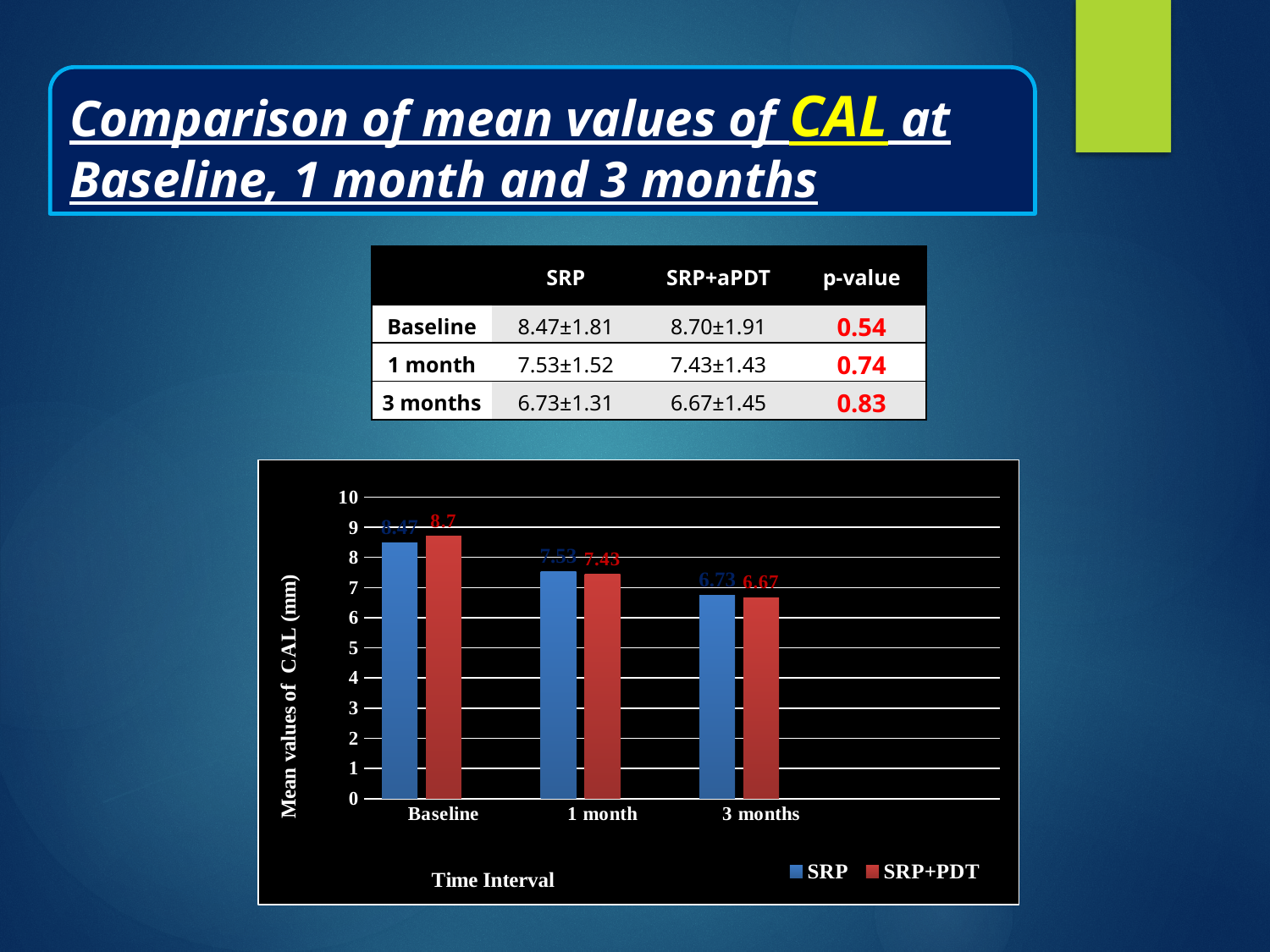
What is the value for SRP+PDT at 3 months in the chart? 6.67 What is the value for SRP at Baseline in the chart? 8.47 What is the value for SRP at 1 month in the chart? 7.53 Which is larger at 1 month, the SRP value or the SRP+PDT value? SRP Do the SRP values rise or fall from Baseline to 3 months? fall How many time intervals are shown on the x axis of the chart? 3 How many series does the chart legend list? 2 At which time interval is the SRP value lowest? 3 months What type of chart is shown on the slide? bar chart What is the difference between the SRP values at Baseline and 3 months? 1.74 What is the value for SRP+PDT at Baseline in the chart? 8.7 At which time interval is the SRP+PDT value highest? Baseline